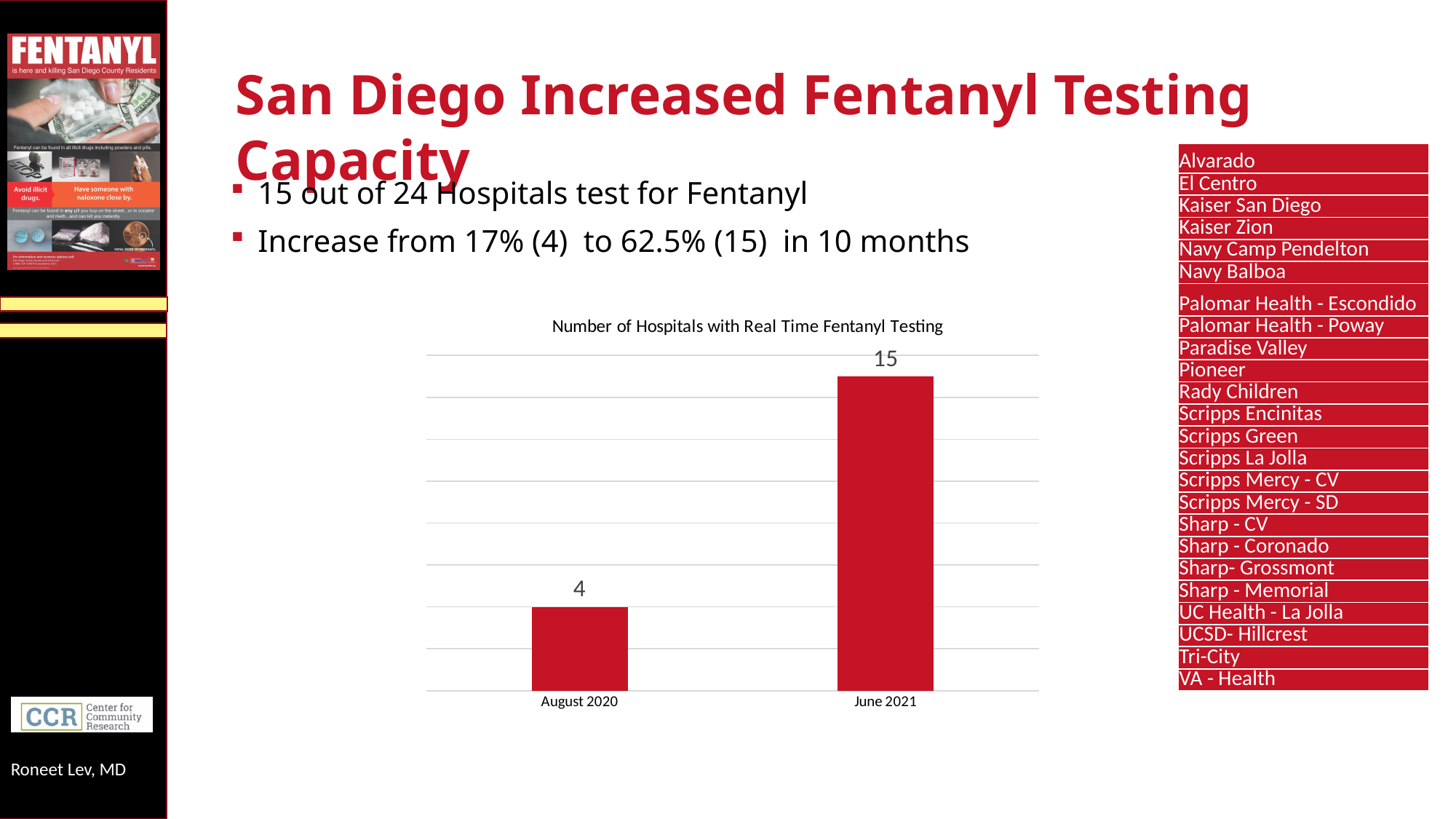
What is the value for August 2020 in the chart? 4 Which is larger, the value for August 2020 or the value for June 2021? June 2021 What kind of chart is shown on the slide? Bar chart Which category has the lowest value in the chart? August 2020 How many categories are shown on the x axis of the chart? 2 What is the value for June 2021 in the chart? 15 What is the title of the chart? Number of Hospitals with Real Time Fentanyl Testing What colour are the bars in the chart? Red Which category has the highest value in the chart? June 2021 Do the values rise or fall from August 2020 to June 2021? Rise What is the difference between the June 2021 and August 2020 values? 11